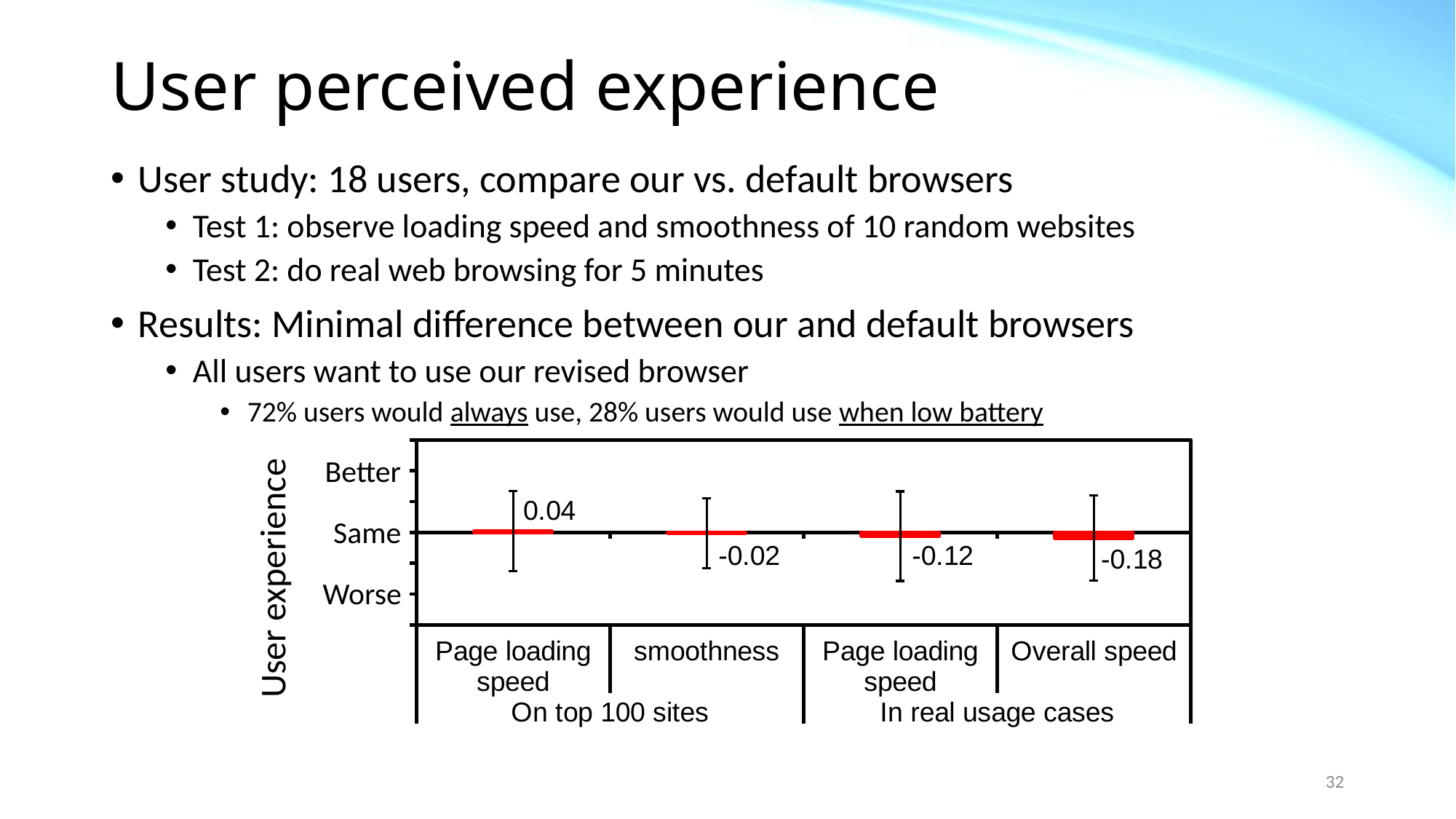
Which category has the lowest value? Overall speed (In real usage cases) Which category has the highest value? Page loading speed (On top 100 sites) Which is larger: the value for smoothness on top 100 sites or the value for Page loading speed in real usage cases? smoothness on top 100 sites How many categories are plotted in the chart? 4 What is the difference between the value for Page loading speed on top 100 sites and the value for Overall speed in real usage cases? 0.22 What is the title of the vertical axis of the chart? User experience What is the value for Page loading speed on top 100 sites? 0.04 What is the value for smoothness on top 100 sites? -0.02 What kind of chart is shown on the slide? Bar chart What is the value for Overall speed in real usage cases? -0.18 Do the values rise or fall from left to right across the categories? Fall What is the value for Page loading speed in real usage cases? -0.12